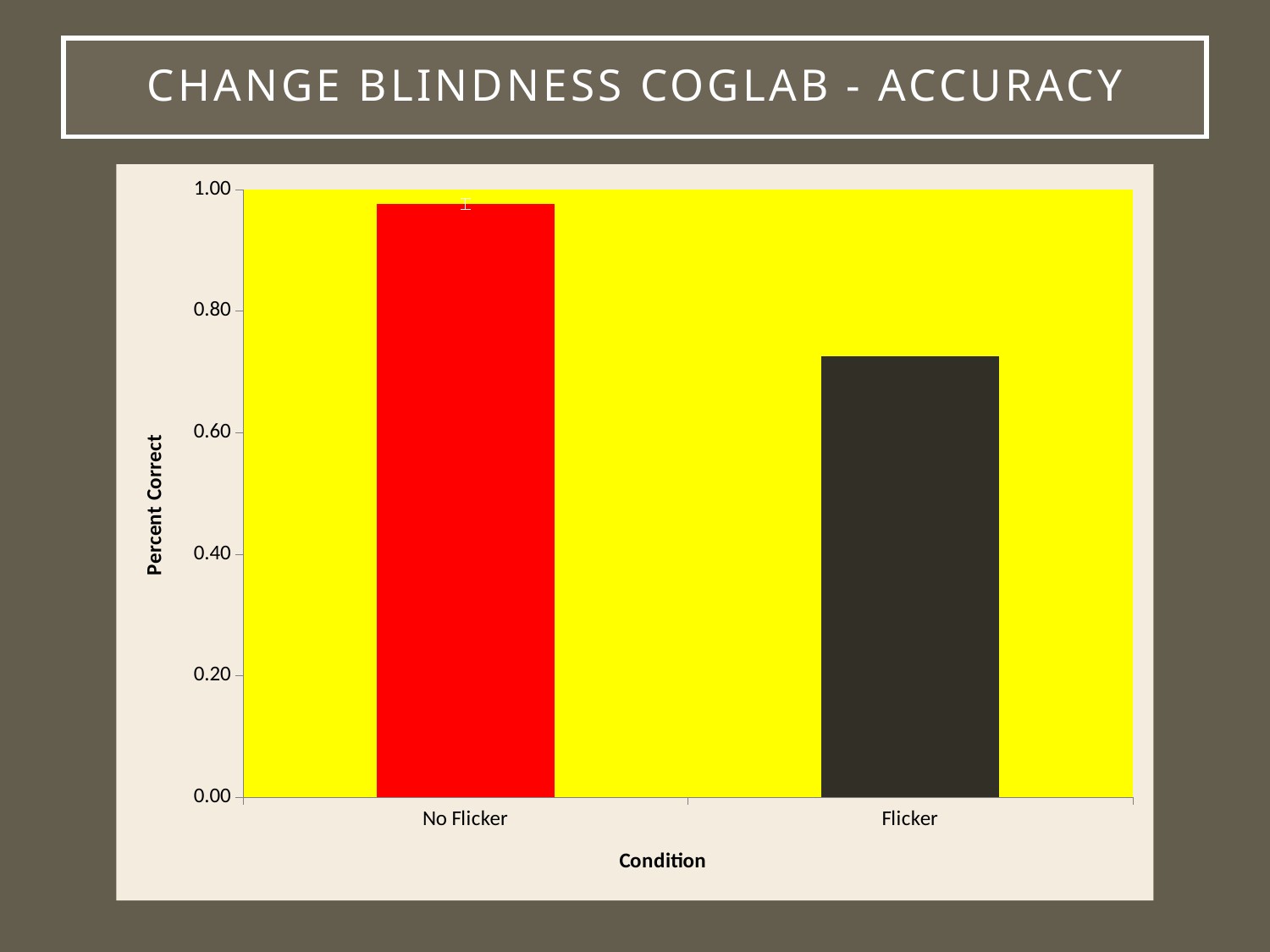
What is the label of the vertical axis? Percent Correct What kind of chart is shown on the slide? bar chart How many conditions are plotted on the x axis? 2 Which condition has the highest percent correct? No Flicker Is the value for Flicker greater or less than 0.80? less Which condition has a larger percent correct, No Flicker or Flicker? No Flicker What is the label of the horizontal axis? Condition Which condition has the lowest percent correct? Flicker Is the value for No Flicker greater or less than 0.80? greater Is the value for Flicker greater or less than 0.60? greater